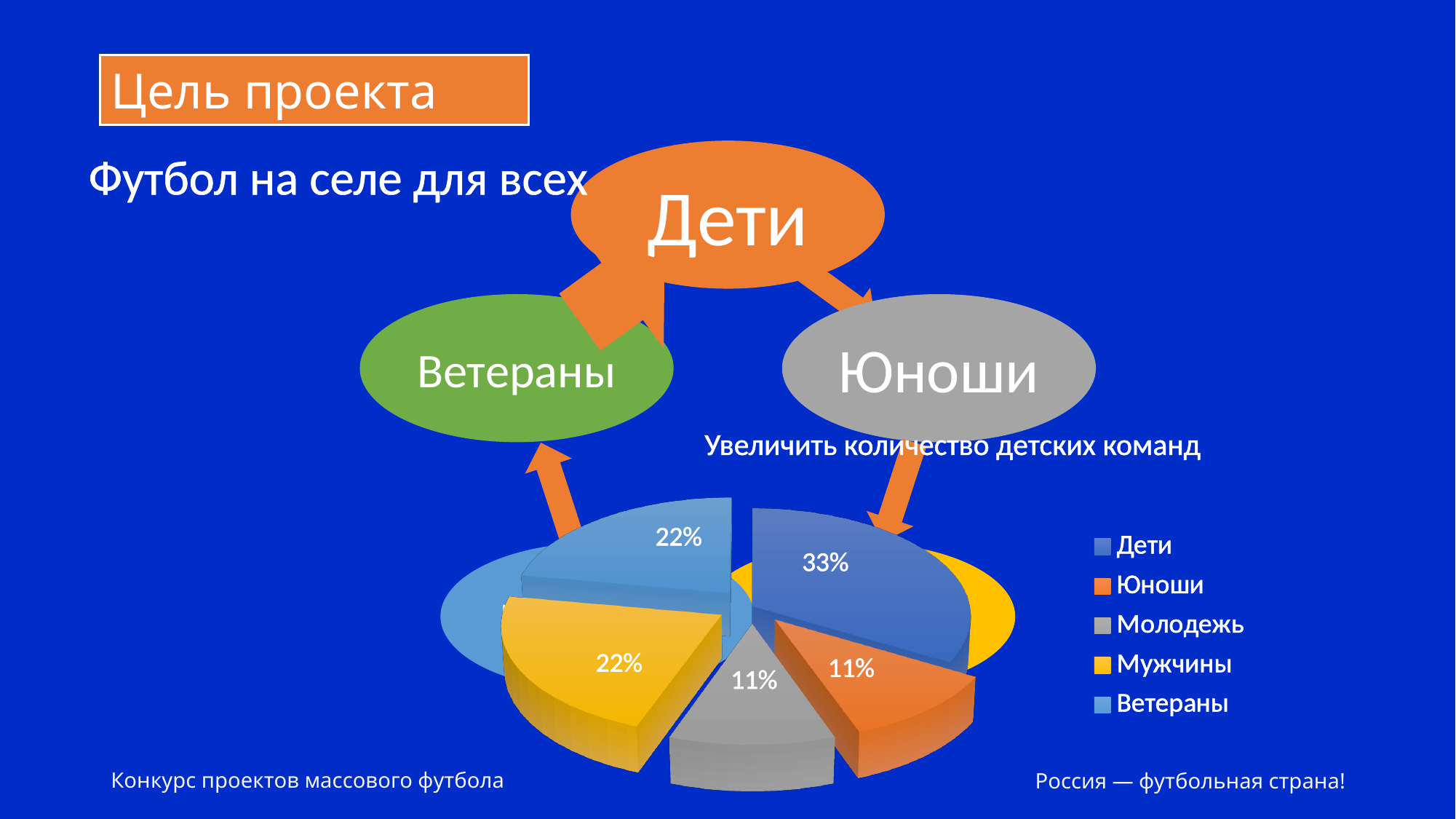
Which category has the largest slice of the pie? Дети What is the difference in percentage points between the Дети slice and the Молодежь slice? 22 How many entries does the legend list? 5 What share of the pie does Юноши have? 11% What share of the pie does Дети have? 33% What share of the pie does Ветераны have? 22% What kind of chart is shown on the slide? pie chart Which is larger, the slice for Дети or the slice for Юноши? Дети What share of the pie does Молодежь have? 11% What share of the pie does Мужчины have? 22% What colour is the Мужчины slice in the pie chart? yellow How many categories does the pie chart have? 5